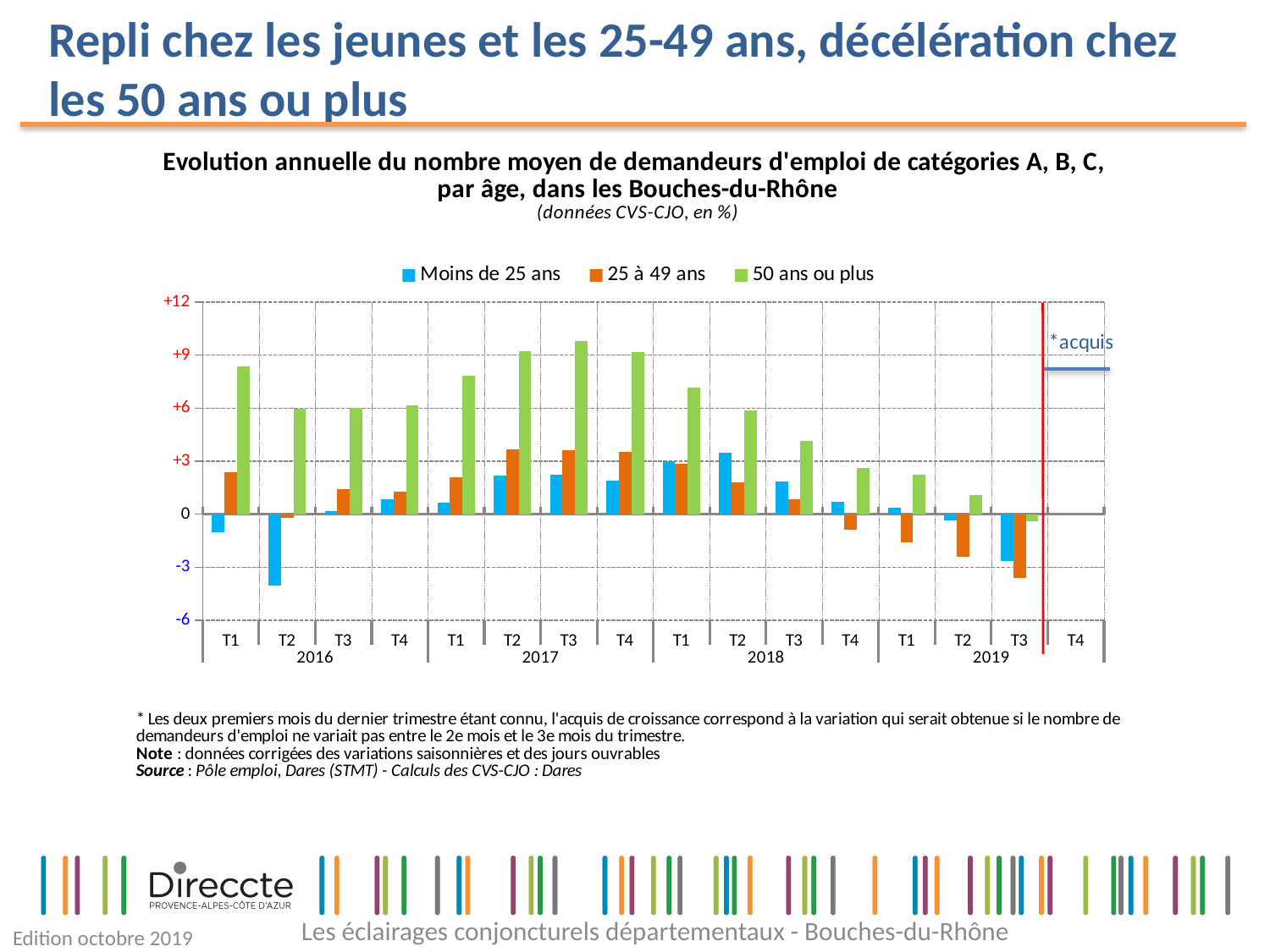
Does the '50 ans ou plus' series rise or fall from T3 2017 to T3 2019? fall Is the value for 'Moins de 25 ans' in T2 2016 greater or less than -3? less In which quarter does the '25 à 49 ans' series reach its lowest value? T3 2019 How many quarters are shown on the x axis, from T1 2016 to T4 2019? 16 Which series is shown in green in the legend? 50 ans ou plus What kind of chart is shown on the slide? bar chart In which quarter does the 'Moins de 25 ans' series reach its lowest value? T2 2016 In T1 2016, which is larger: the value for '50 ans ou plus' or the value for '25 à 49 ans'? 50 ans ou plus How many series does the legend list? 3 Is the value for '50 ans ou plus' in T3 2017 greater or less than +9? greater Is the value for '25 à 49 ans' in T3 2019 greater or less than -3? less In which quarter does the '50 ans ou plus' series reach its highest value? T3 2017